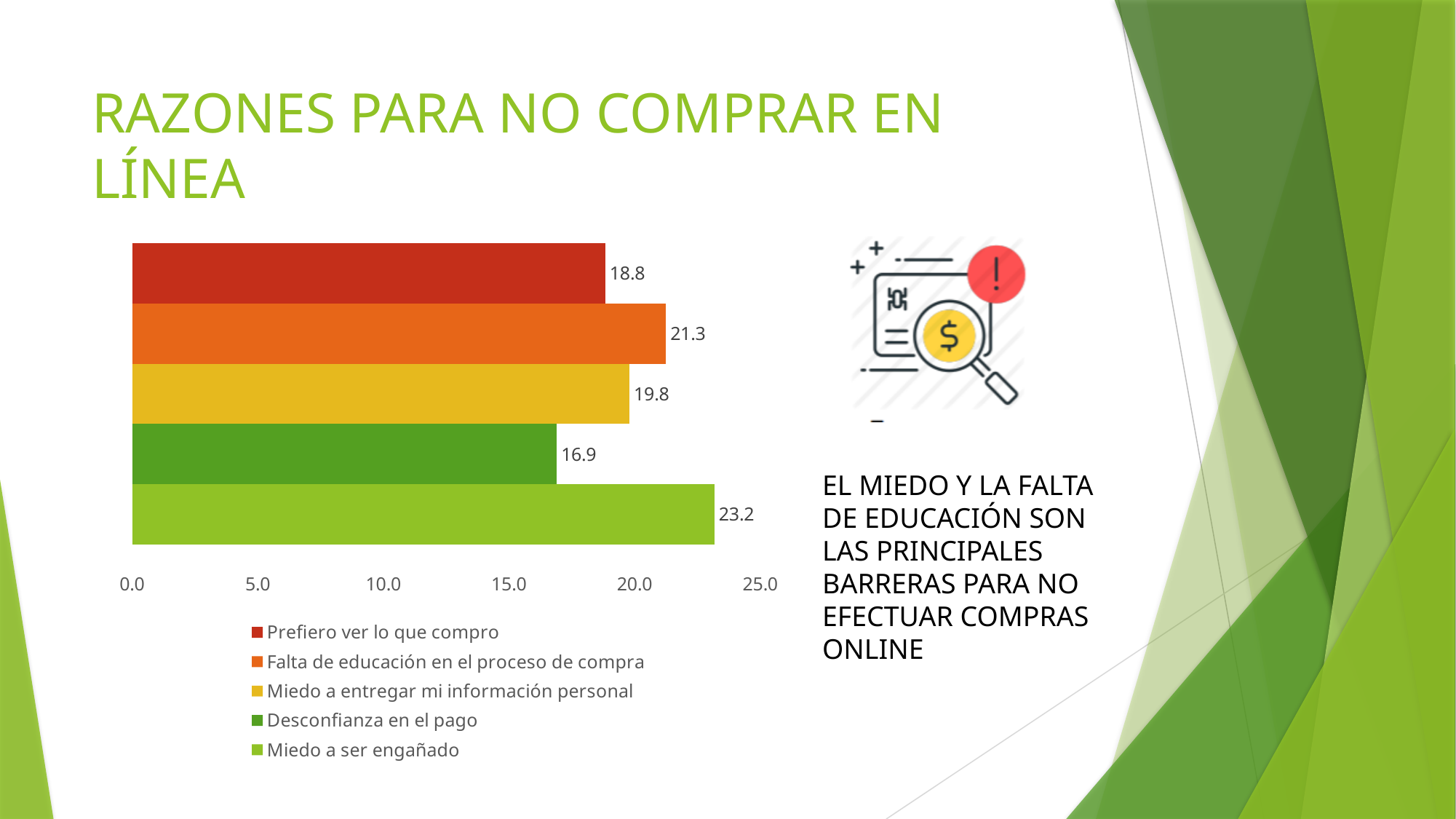
What kind of chart is shown on the slide? Bar chart What is the value for "Prefiero ver lo que compro"? 18.8 Is the value for "Falta de educación en el proceso de compra" greater or less than 20.0? greater How many categories are shown in the chart? 5 Which category has the lowest value? Desconfianza en el pago What is the value for "Falta de educación en el proceso de compra"? 21.3 What is the difference between the values for "Miedo a ser engañado" and "Desconfianza en el pago"? 6.3 Which category has the highest value? Miedo a ser engañado Which is larger: the value for "Miedo a entregar mi información personal" or the value for "Prefiero ver lo que compro"? Miedo a entregar mi información personal What is the value for "Miedo a ser engañado"? 23.2 What is the value for "Desconfianza en el pago"? 16.9 What colour is the bar for "Miedo a entregar mi información personal"? Yellow